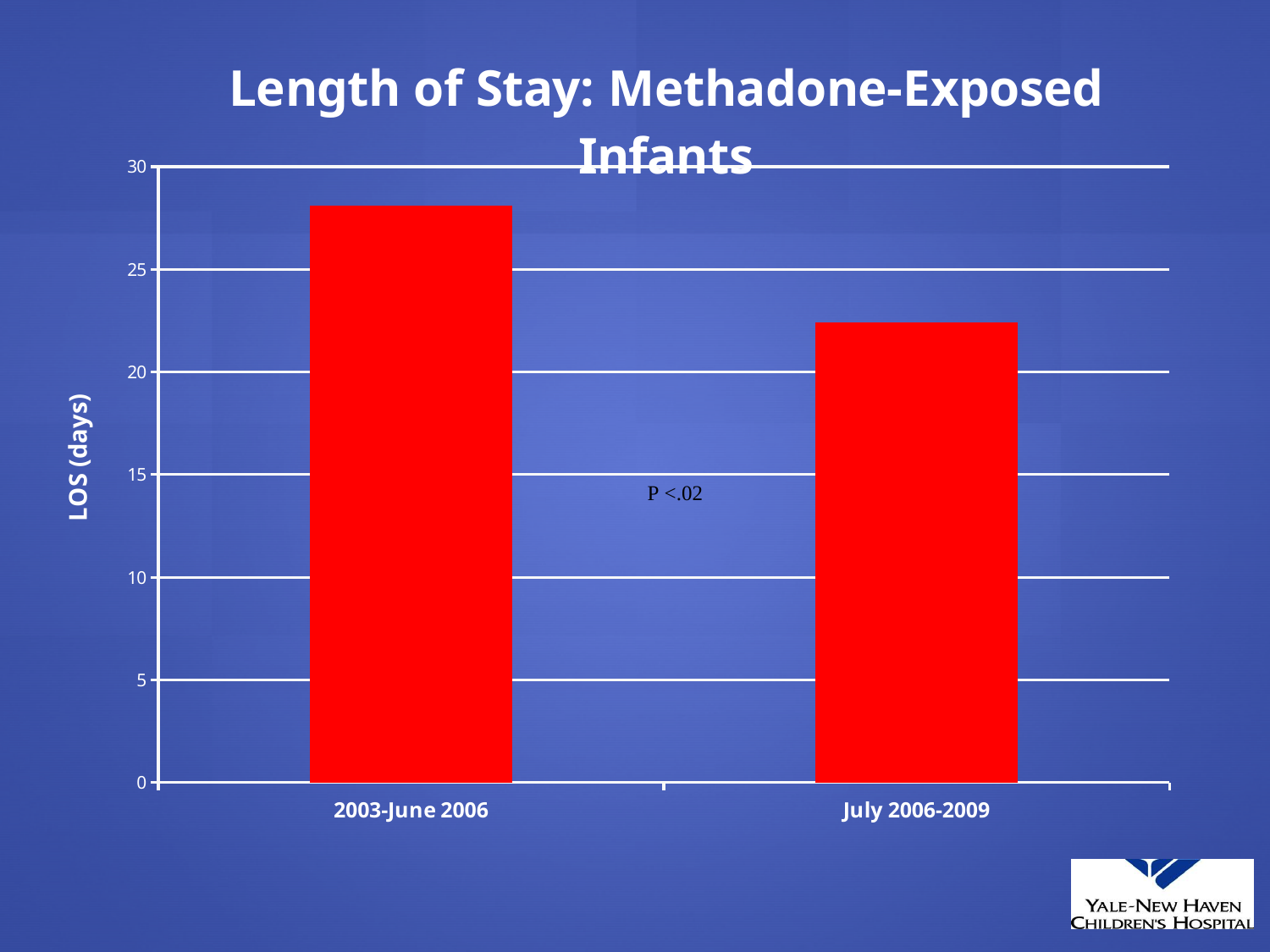
Which period has the higher length of stay? 2003-June 2006 What is the label of the y axis? LOS (days) Do the values rise or fall from the first period to the second? fall Is the value for 2003-June 2006 greater or less than 30? less What p-value is printed on the chart? P <.02 Is the value for July 2006-2009 greater or less than 20? greater What kind of chart is shown on the slide? bar chart Which period has the lower length of stay? July 2006-2009 Is the value for July 2006-2009 greater or less than 25? less How many categories are shown on the x axis? 2 Which is larger, the value for 2003-June 2006 or the value for July 2006-2009? 2003-June 2006